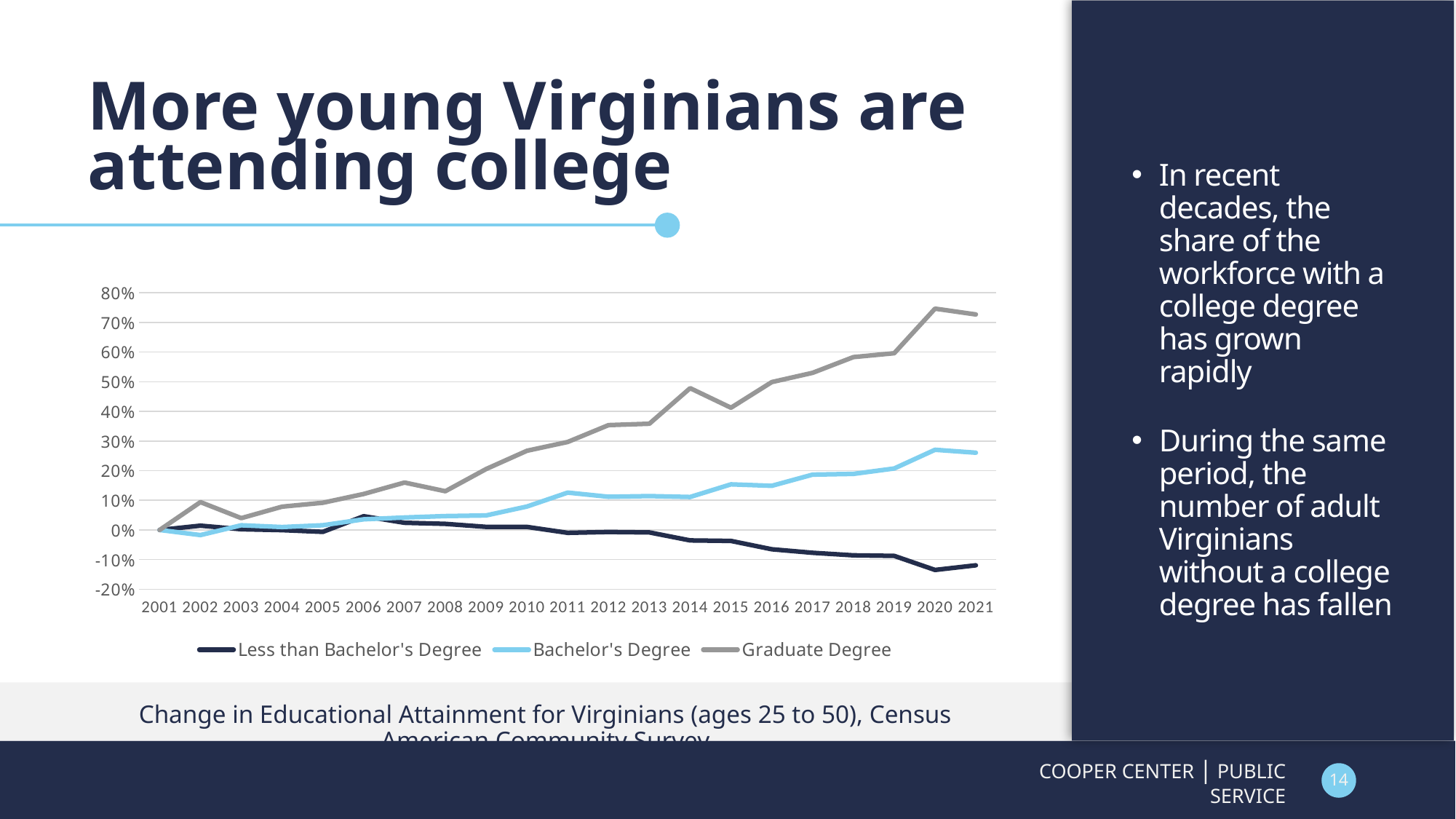
Is the value for Graduate Degree in 2014 greater or less than 40%? greater Is the value for Graduate Degree in 2021 greater or less than 70%? greater Which is larger in 2021, the value for Graduate Degree or the value for Bachelor's Degree? Graduate Degree How many series does the legend list? 3 How many years are plotted along the x axis? 21 Which series has the lowest value in 2021? Less than Bachelor's Degree Does the Graduate Degree line generally rise or fall from 2001 to 2021? rise Is the value for Bachelor's Degree in 2021 greater or less than 30%? less What is the value for Graduate Degree in 2001? 0% What kind of chart is shown on the slide? line chart Which series has the highest value in 2021? Graduate Degree Does the Less than Bachelor's Degree line generally rise or fall from 2001 to 2021? fall